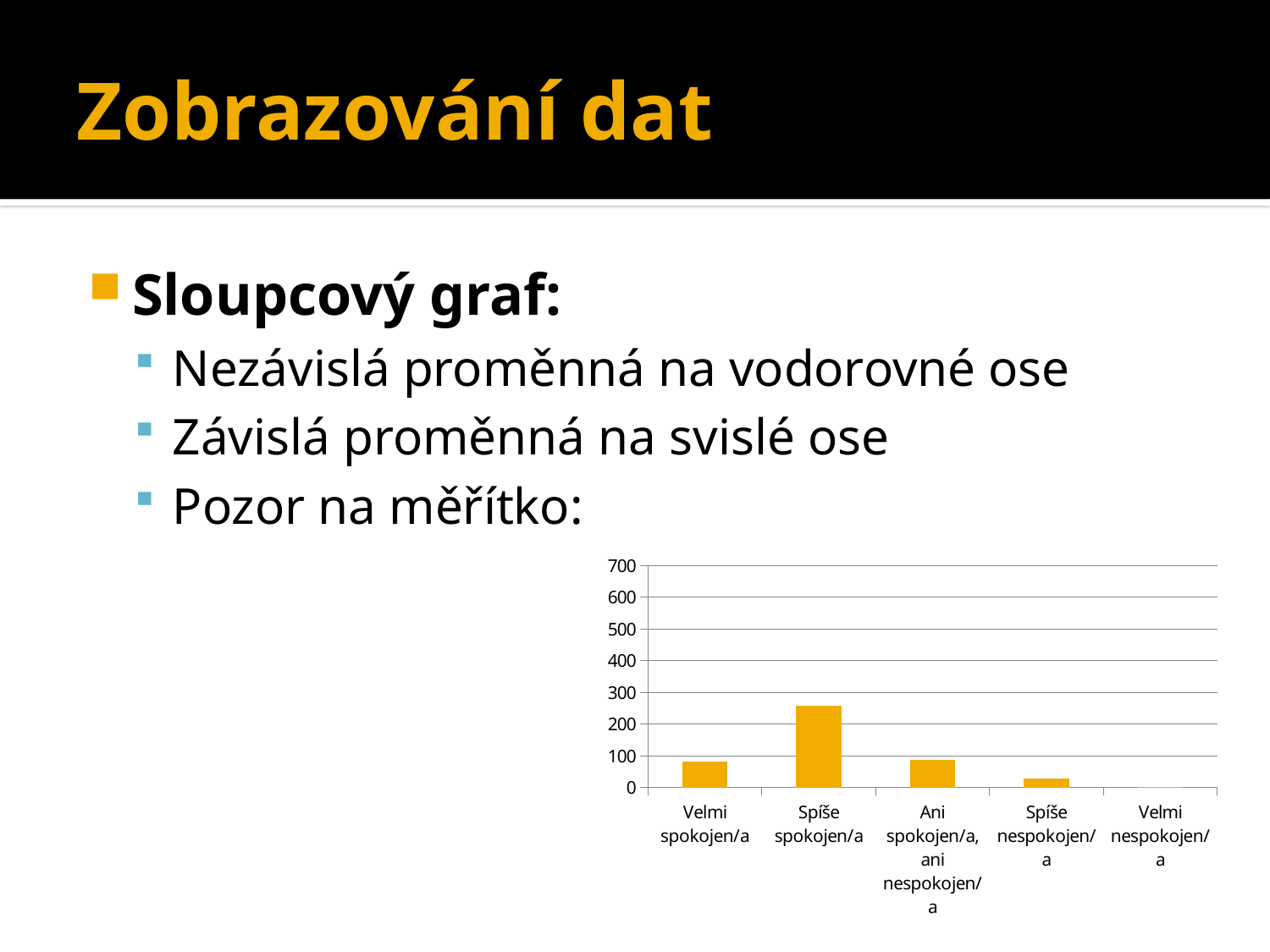
Which is larger, the value for Ani spokojen/a, ani nespokojen/a or the value for Velmi nespokojen/a? Ani spokojen/a, ani nespokojen/a Is the value for Spíše spokojen/a greater or less than 300? less What kind of chart is shown on the slide? bar chart Which category has the highest bar in the chart? Spíše spokojen/a How many categories are shown on the x axis of the chart? 5 Is the value for Spíše spokojen/a greater or less than 200? greater Which category has the lowest bar in the chart? Velmi nespokojen/a Which is larger, the value for Spíše spokojen/a or the value for Spíše nespokojen/a? Spíše spokojen/a Is the value for Spíše nespokojen/a greater or less than 100? less What colour are the bars in the chart? orange What is the highest value shown on the vertical axis of the chart? 700